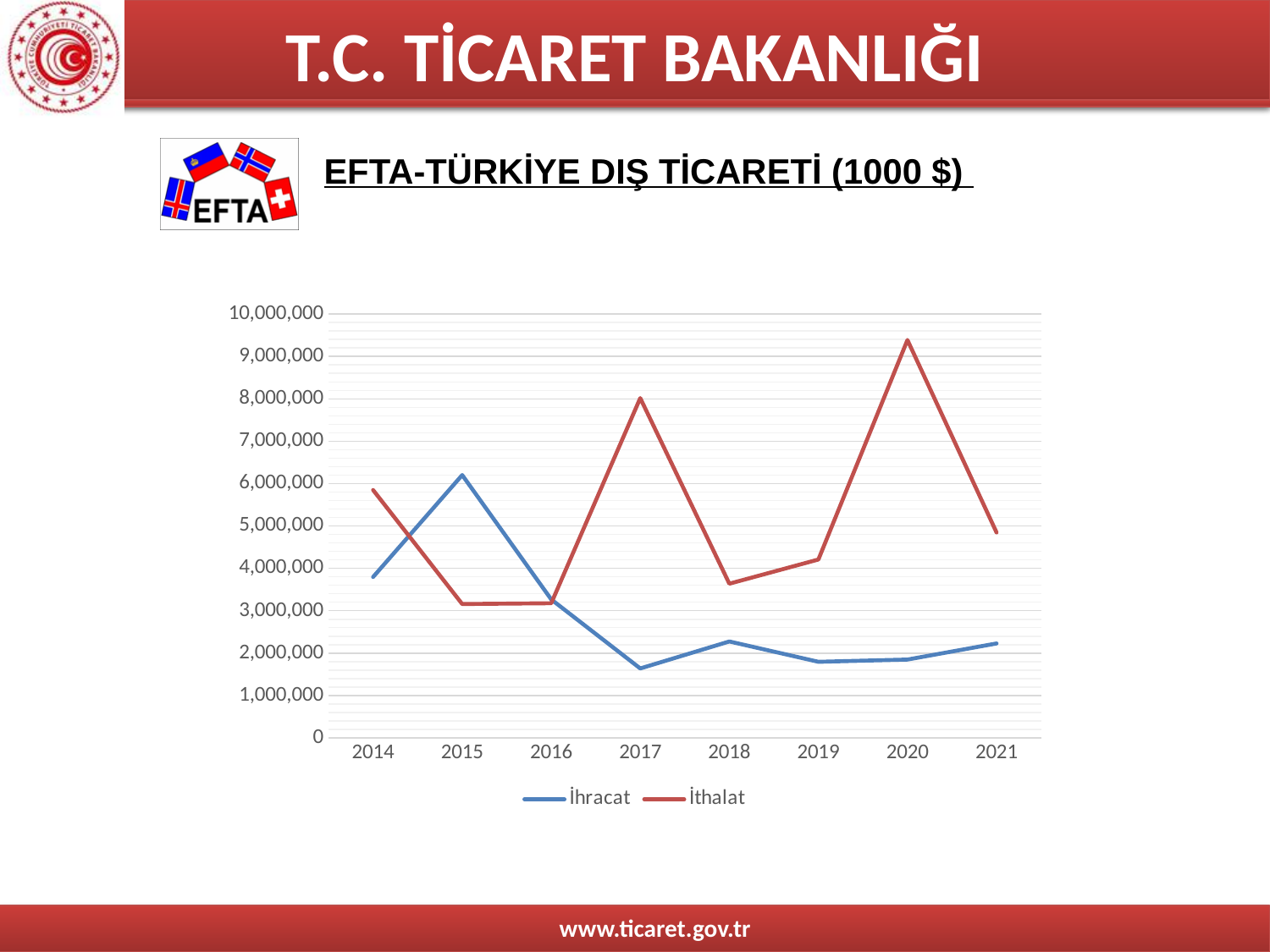
What kind of chart is shown on the slide? line chart In 2015, which is larger, İhracat or İthalat? İhracat In which year is the İhracat value highest? 2015 How many series does the legend list? 2 Is the İthalat value for 2021 greater or less than 5,000,000? less Is the İhracat value for 2015 greater or less than 6,000,000? greater Is the İhracat value for 2017 greater or less than 2,000,000? less In 2014, which is larger, İhracat or İthalat? İthalat Does the İhracat line rise or fall from 2015 to 2017? fall How many years are plotted along the x axis? 8 In which year is the İthalat value highest? 2020